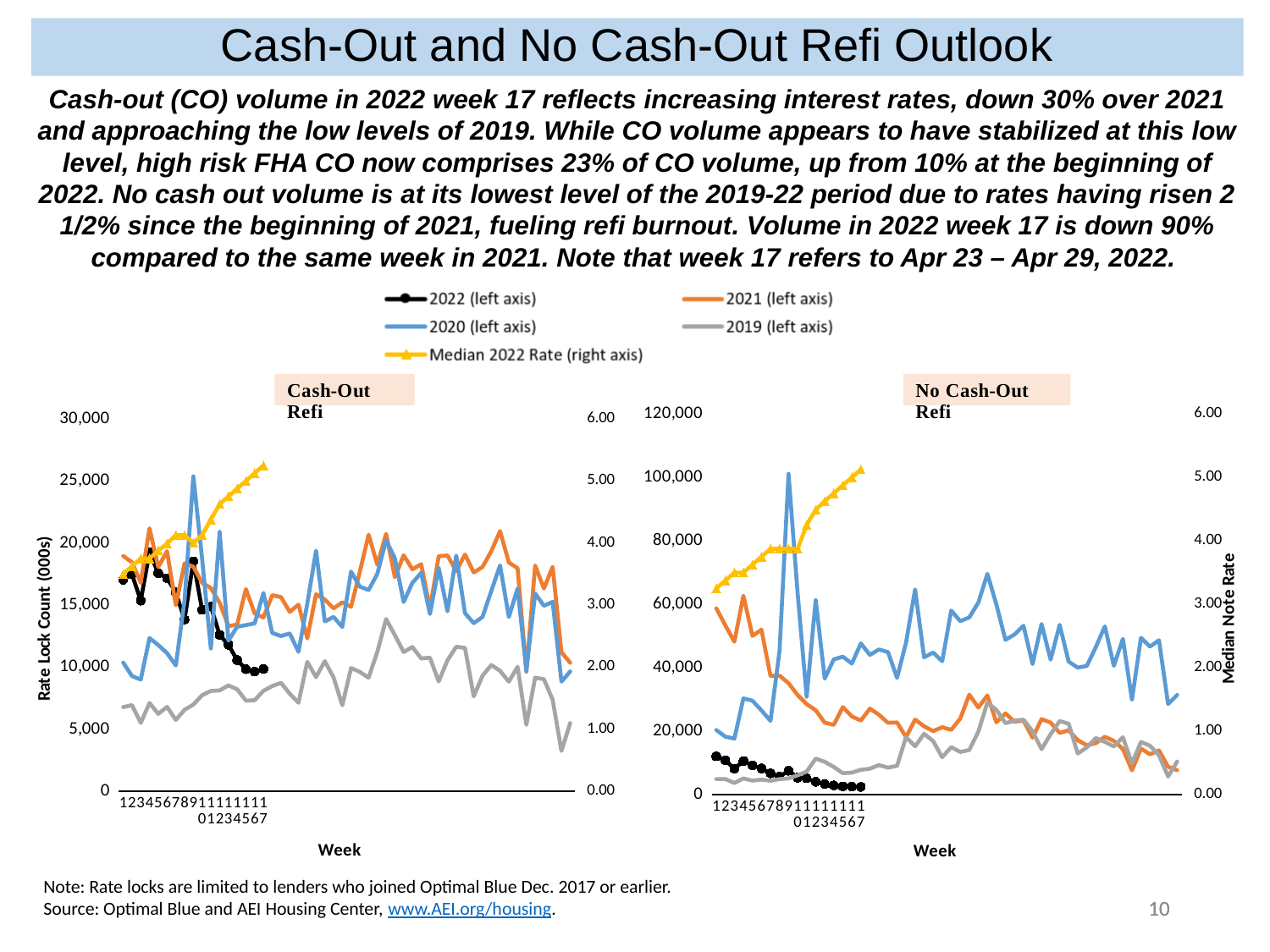
What kind of chart is the Cash-Out Refi chart? line chart In the Cash-Out Refi chart, does the Median 2022 Rate series rise or fall along the x axis? rise In the No Cash-Out Refi chart, which series reaches the highest rate lock count? 2020 What is the x-axis label on the No Cash-Out Refi chart? Week In the No Cash-Out Refi chart, does the 2022 series rise or fall from week 1 to week 17? fall In the No Cash-Out Refi chart, is the 2022 value at week 17 greater or less than 20,000? less In the No Cash-Out Refi chart, at week 17, which series has the larger value: 2022 or 2020? 2020 In the Cash-Out Refi chart, is the 2022 value at week 1 greater or less than 15,000? greater In the Cash-Out Refi chart, which series reaches the highest rate lock count? 2020 How many series does the legend list for the charts? 5 Which series is plotted on the right axis according to the legend? Median 2022 Rate In the No Cash-Out Refi chart, is the peak value of the 2020 series greater or less than 80,000? greater